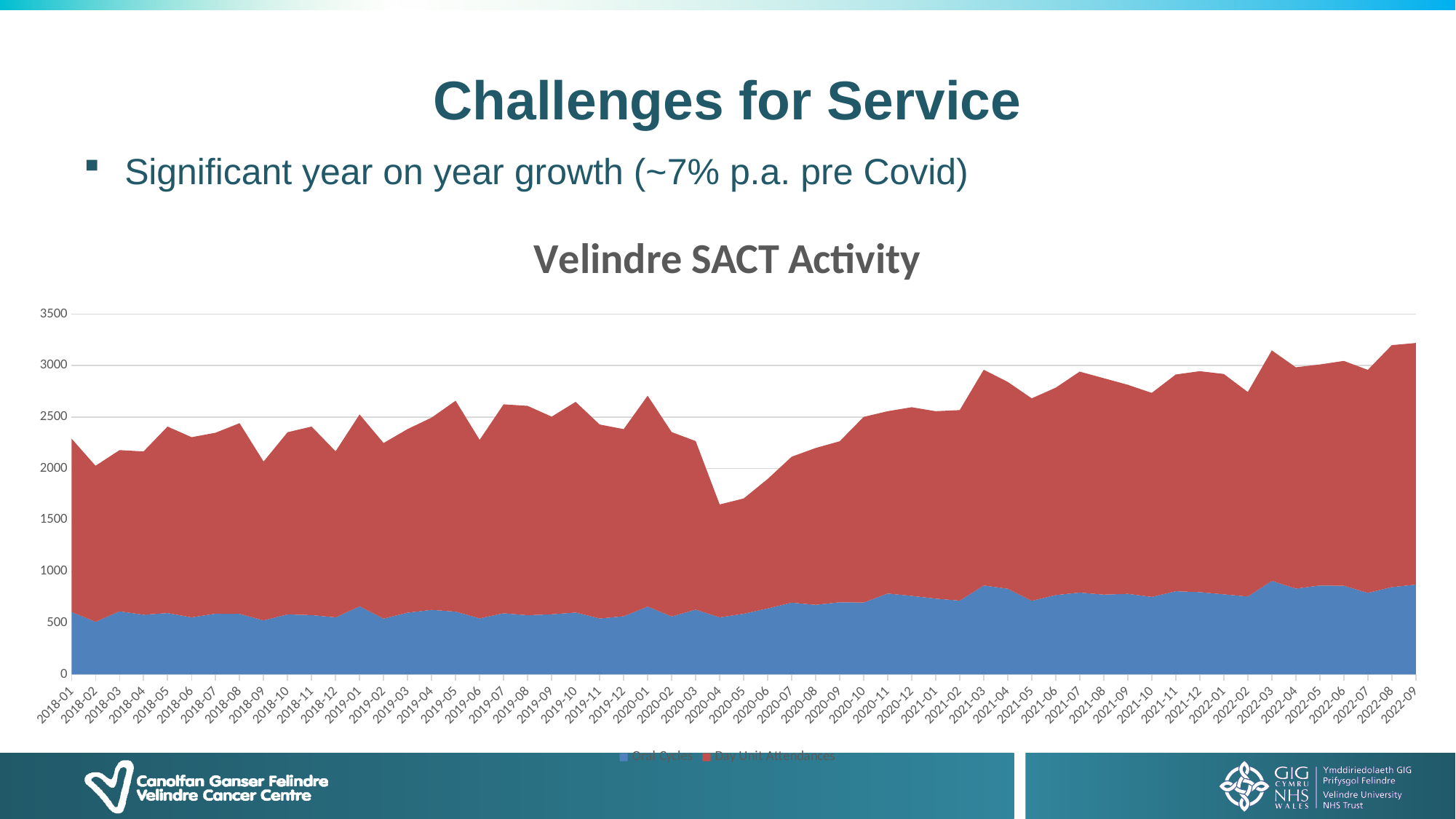
How many monthly points are plotted along the x axis of the Velindre SACT Activity chart? 57 Is the Oral Cycles value for 2018-01 greater or less than 500? greater What kind of chart is shown on the slide? Stacked area chart Is the Oral Cycles value for 2022-09 greater or less than 1000? less Which colour represents Day Unit Attendances in the Velindre SACT Activity chart? Red What are the two series named in the legend of the Velindre SACT Activity chart? Oral Cycles and Day Unit Attendances Is the total SACT activity for 2020-04 greater or less than 2000? less Which month has the larger total SACT activity, 2020-04 or 2022-09? 2022-09 How many series does the legend of the Velindre SACT Activity chart list? 2 Does the total SACT activity rise or fall overall from 2018-01 to 2022-09? Rise In which month is the total SACT activity lowest in the Velindre SACT Activity chart? 2020-04